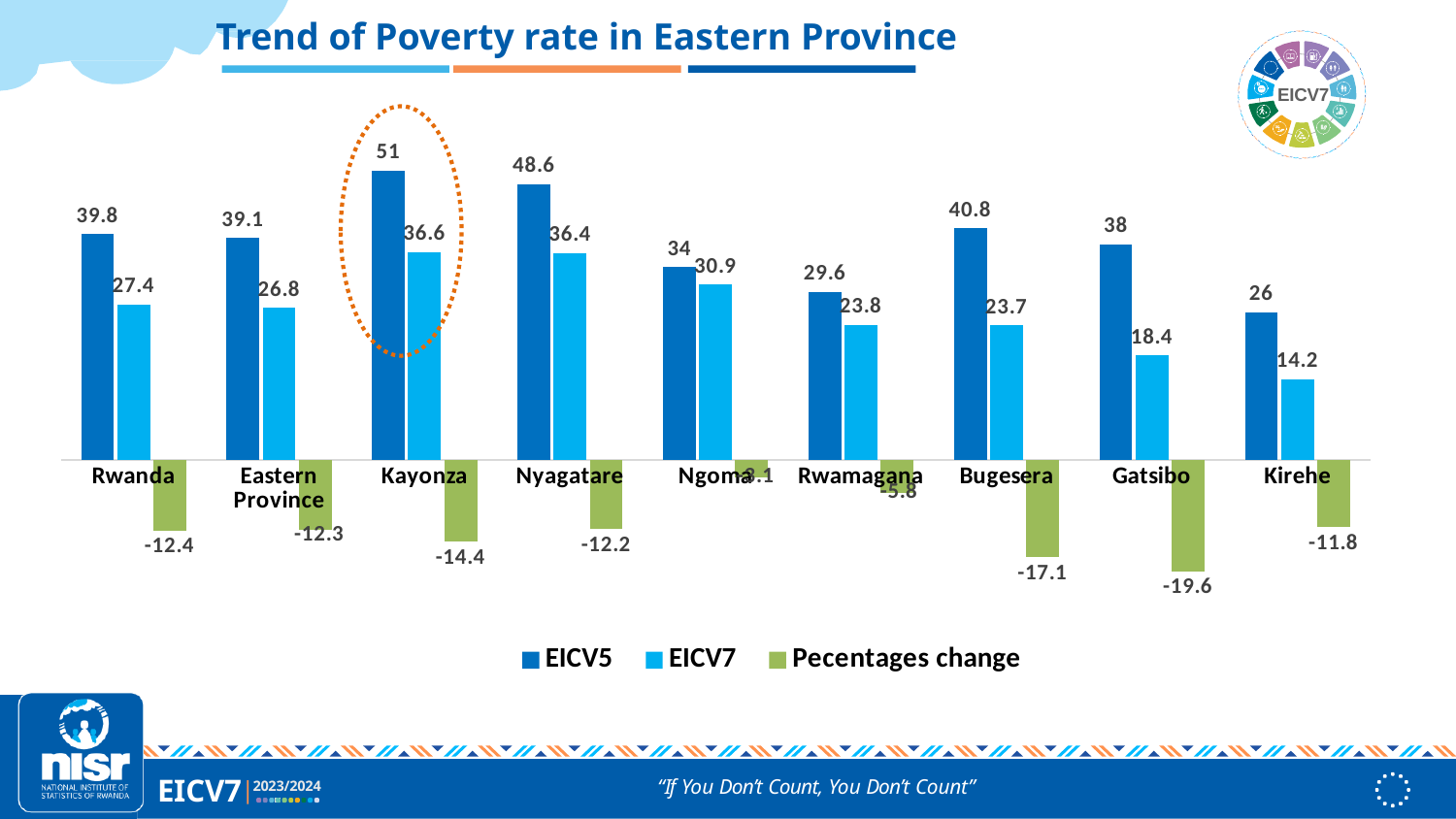
What is the EICV5 poverty rate for Kayonza? 51 How many categories are shown on the x axis? 9 Which category has the highest EICV5 poverty rate? Kayonza How many series does the legend list? 3 Which is larger, the EICV7 value for Rwanda or the EICV7 value for Rwamagana? Rwanda Which category has the most negative percentage change? Gatsibo What type of chart is shown on the slide? Bar chart What is the difference between the EICV5 and EICV7 values for Bugesera? 17.1 What is the EICV5 value for Eastern Province? 39.1 What is the EICV7 poverty rate for Kirehe? 14.2 Which category has the lowest EICV7 poverty rate? Kirehe What is the percentage change shown for Gatsibo? -19.6